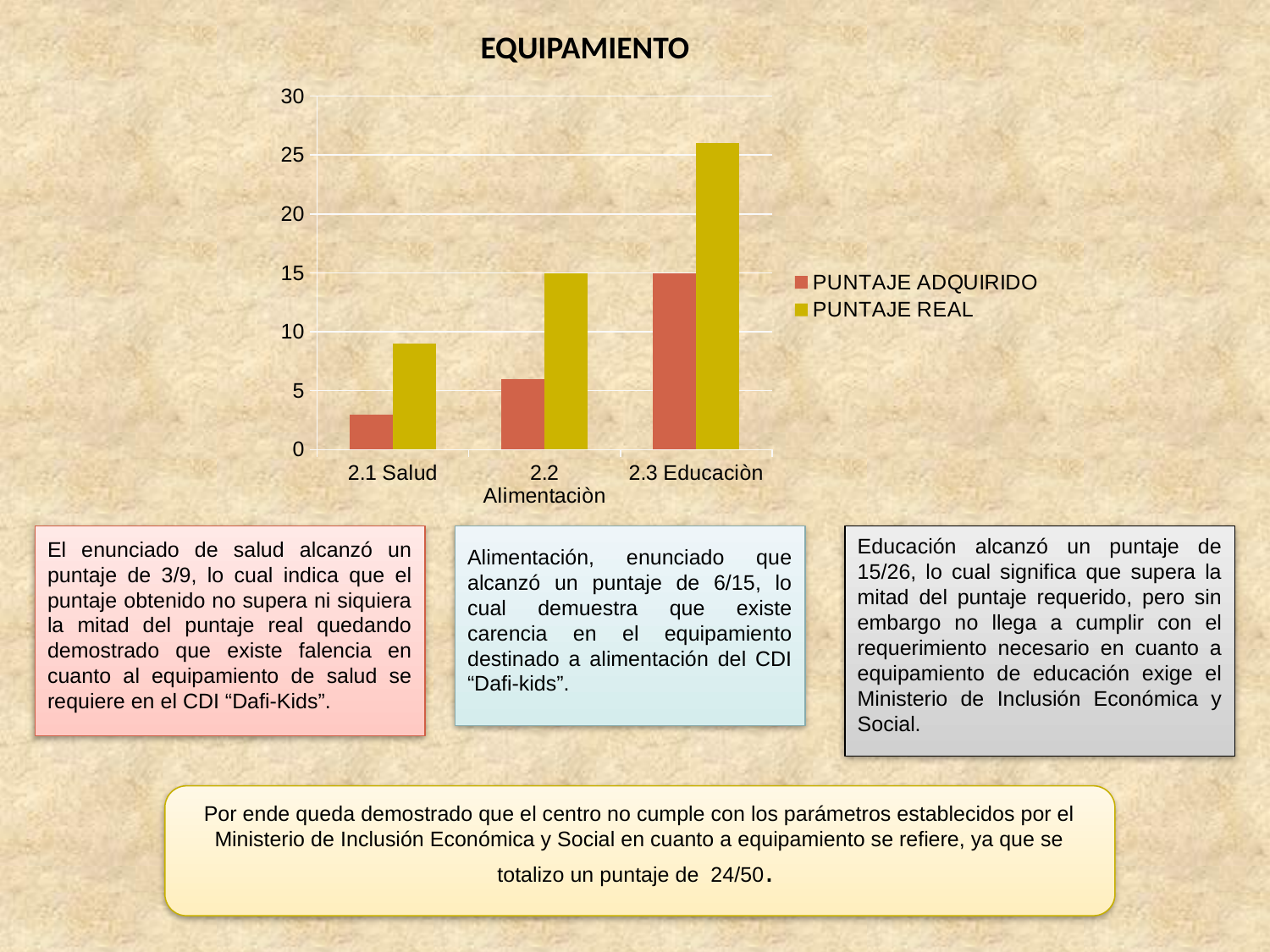
What kind of chart is shown on the slide? bar chart Is the PUNTAJE REAL value for 2.1 Salud greater or less than 5? greater Is the PUNTAJE REAL value for 2.3 Educaciòn greater or less than 25? greater What is the PUNTAJE REAL value for 2.2 Alimentaciòn? 15 Do the PUNTAJE ADQUIRIDO values rise or fall from 2.1 Salud to 2.3 Educaciòn? rise What is the PUNTAJE ADQUIRIDO value for 2.3 Educaciòn? 15 Which category has the lowest PUNTAJE ADQUIRIDO value? 2.1 Salud Which category has the highest PUNTAJE REAL value? 2.3 Educaciòn Is the PUNTAJE ADQUIRIDO value for 2.1 Salud greater or less than 5? less For 2.1 Salud, which is larger, PUNTAJE ADQUIRIDO or PUNTAJE REAL? PUNTAJE REAL How many series does the legend list? 2 How many categories are shown on the x axis? 3